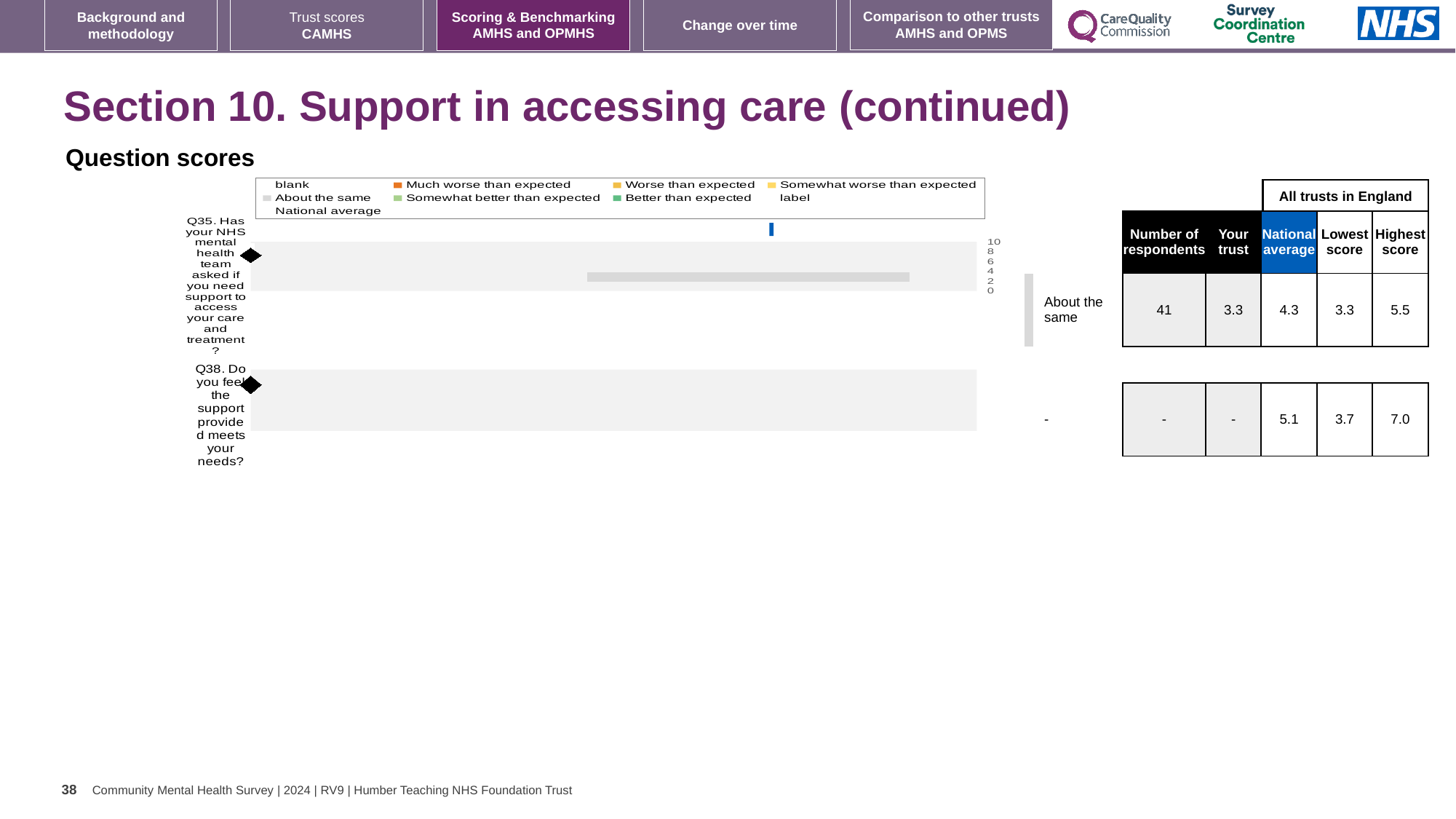
What kind of chart is shown under 'Question scores'? bar chart Which question has the larger national average in the table, Q35 or Q38? Q38 In the table beside the chart, what is the highest score for Q38? 7.0 What is the heading above the chart? Question scores What benchmark category is shown next to the chart for Q35? About the same In the table beside the chart, what is the national average for Q35? 4.3 How many questions (categories) are plotted on the chart? 2 In the table beside the chart, how many respondents are recorded for Q35? 41 What is the difference between the highest score and the lowest score for Q35 in the table? 2.2 In the table beside the chart, what is the lowest score for Q38? 3.7 In the table beside the chart, what is the 'Your trust' score for Q35? 3.3 How many entries does the chart legend list? 9